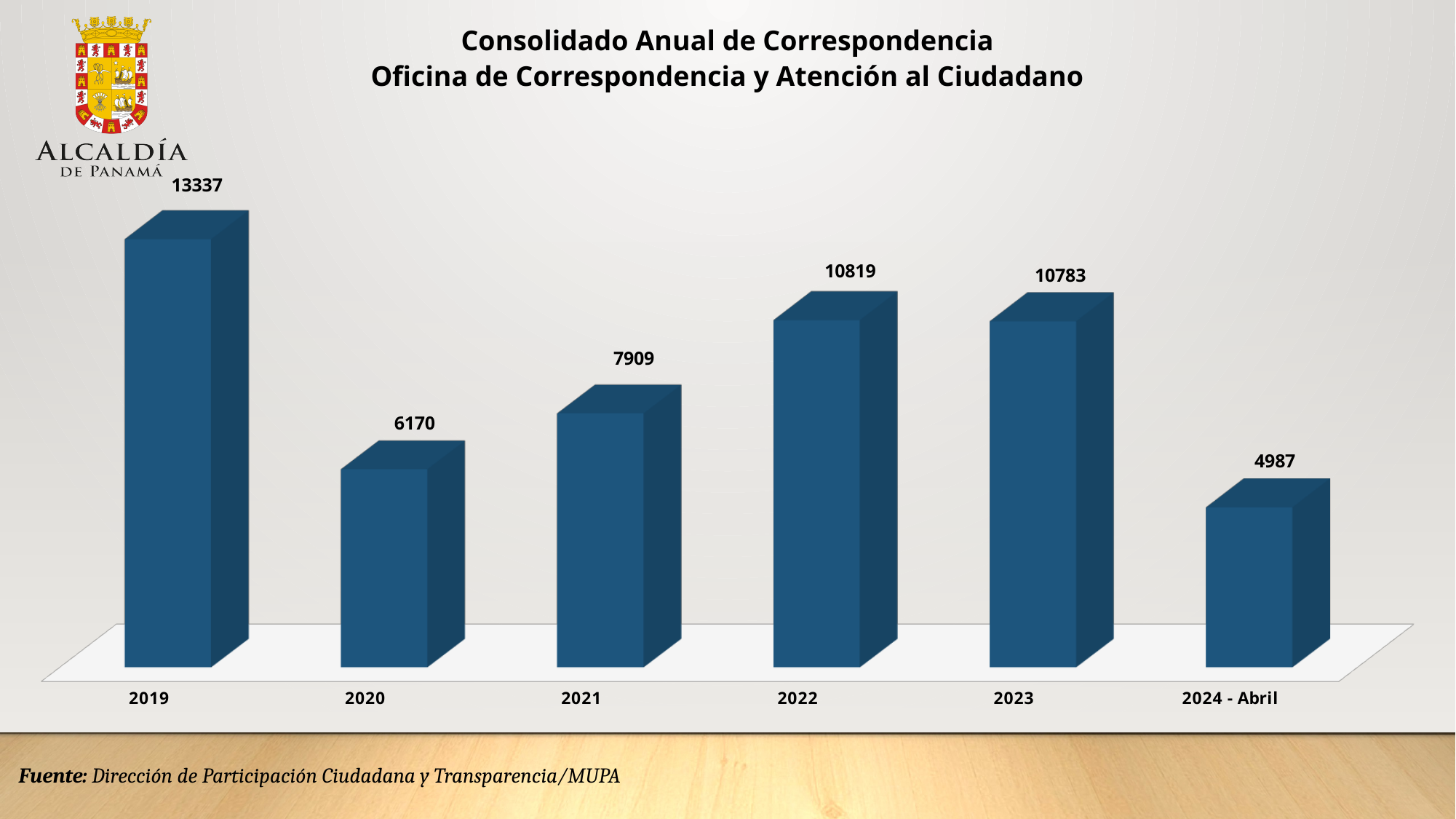
What is the source cited at the bottom of the slide? Dirección de Participación Ciudadana y Transparencia/MUPA Which category has the highest value? 2019 What is the value for 2024 - Abril? 4987 Do the values rise or fall from 2020 to 2022? rise What is the difference between the values for 2019 and 2020? 7167 What is the value for 2022? 10819 How many categories are shown on the x axis? 6 What is the value for 2019? 13337 Which category has the lowest value? 2024 - Abril Which is larger, the value for 2021 or the value for 2020? 2021 What is the difference between the values for 2022 and 2023? 36 What kind of chart is shown on the slide? bar chart